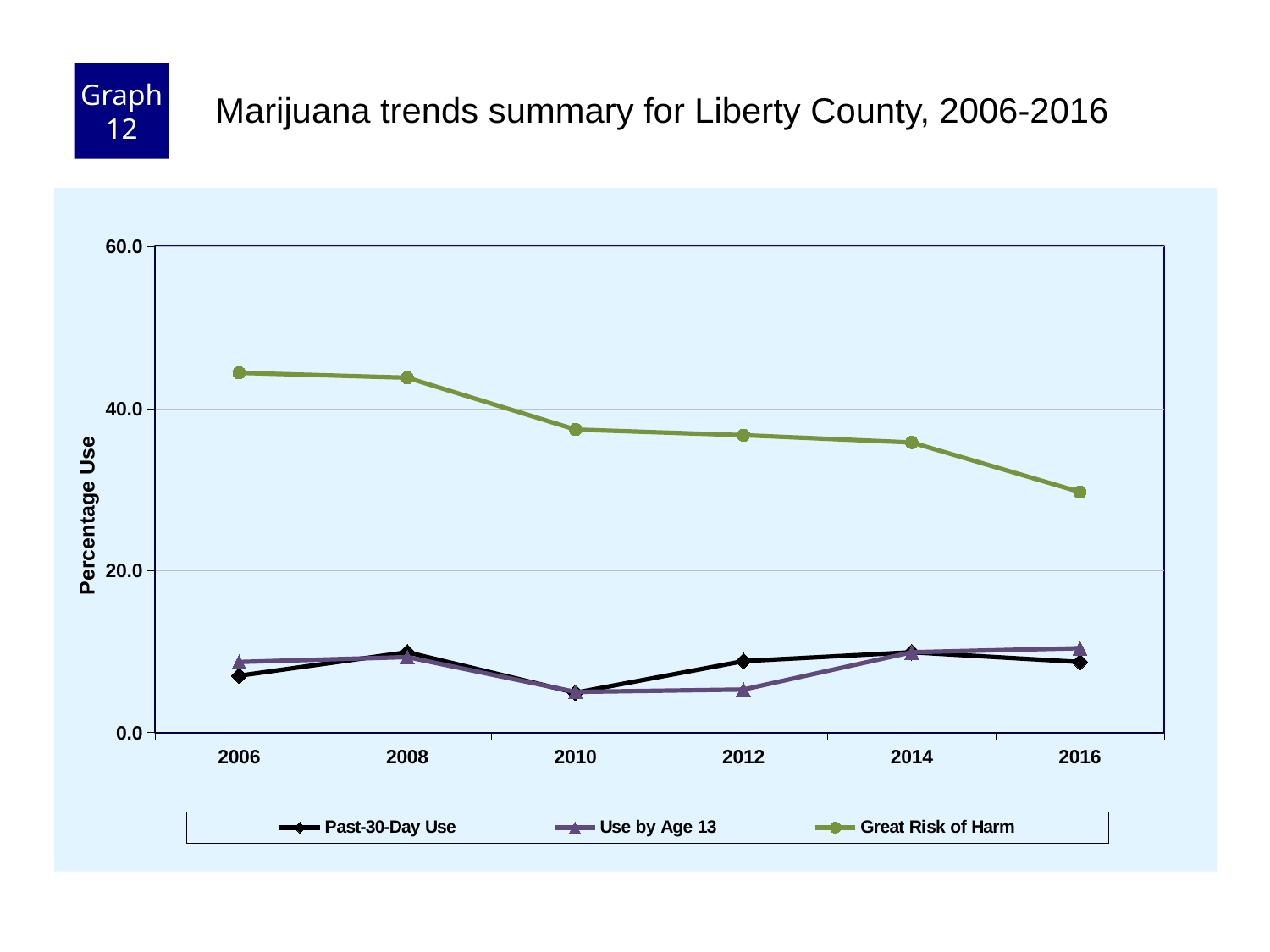
How many years are plotted along the x axis? 6 Does the Great Risk of Harm series rise or fall from 2006 to 2016? Fall In 2016, which is larger: Great Risk of Harm or Past-30-Day Use? Great Risk of Harm Is the Past-30-Day Use value for 2014 greater or less than 20.0? less What is the label on the y axis? Percentage Use In which year is the Past-30-Day Use value lowest? 2010 Is the Great Risk of Harm value for 2016 greater or less than 40.0? less How many series does the legend list? 3 Which is larger for Great Risk of Harm: the 2006 value or the 2016 value? 2006 In which year is the Great Risk of Harm value lowest? 2016 Is the Great Risk of Harm value for 2006 greater or less than 40.0? greater What kind of chart is shown on the slide? Line chart